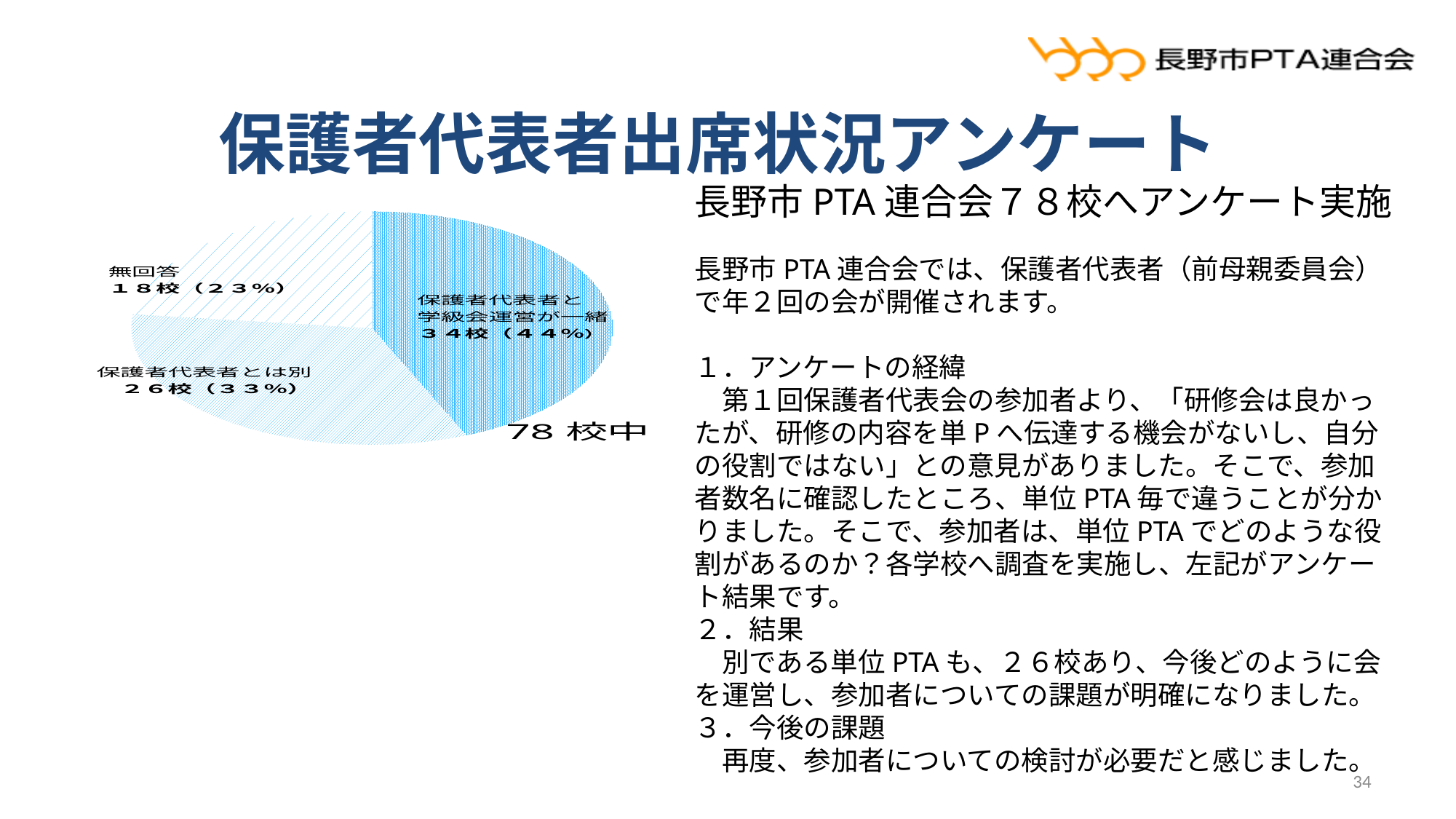
How many schools are in the 無回答 slice? 18校 How many more schools answered 保護者代表者と学級会運営が一緒 than 保護者代表者とは別? 8校 How many schools answered 保護者代表者とは別? 26校 How many slices does the pie chart have? 3 Which slice of the pie chart is the largest? 保護者代表者と学級会運営が一緒 What percentage of the pie is 無回答? 23% What percentage of the pie is 保護者代表者とは別? 33% How many schools answered 保護者代表者と学級会運営が一緒? 34校 What is the total number of schools shown for the pie chart? 78校 What percentage of the pie is 保護者代表者と学級会運営が一緒? 44% Which slice of the pie chart is the smallest? 無回答 What kind of chart is shown on the slide? pie chart